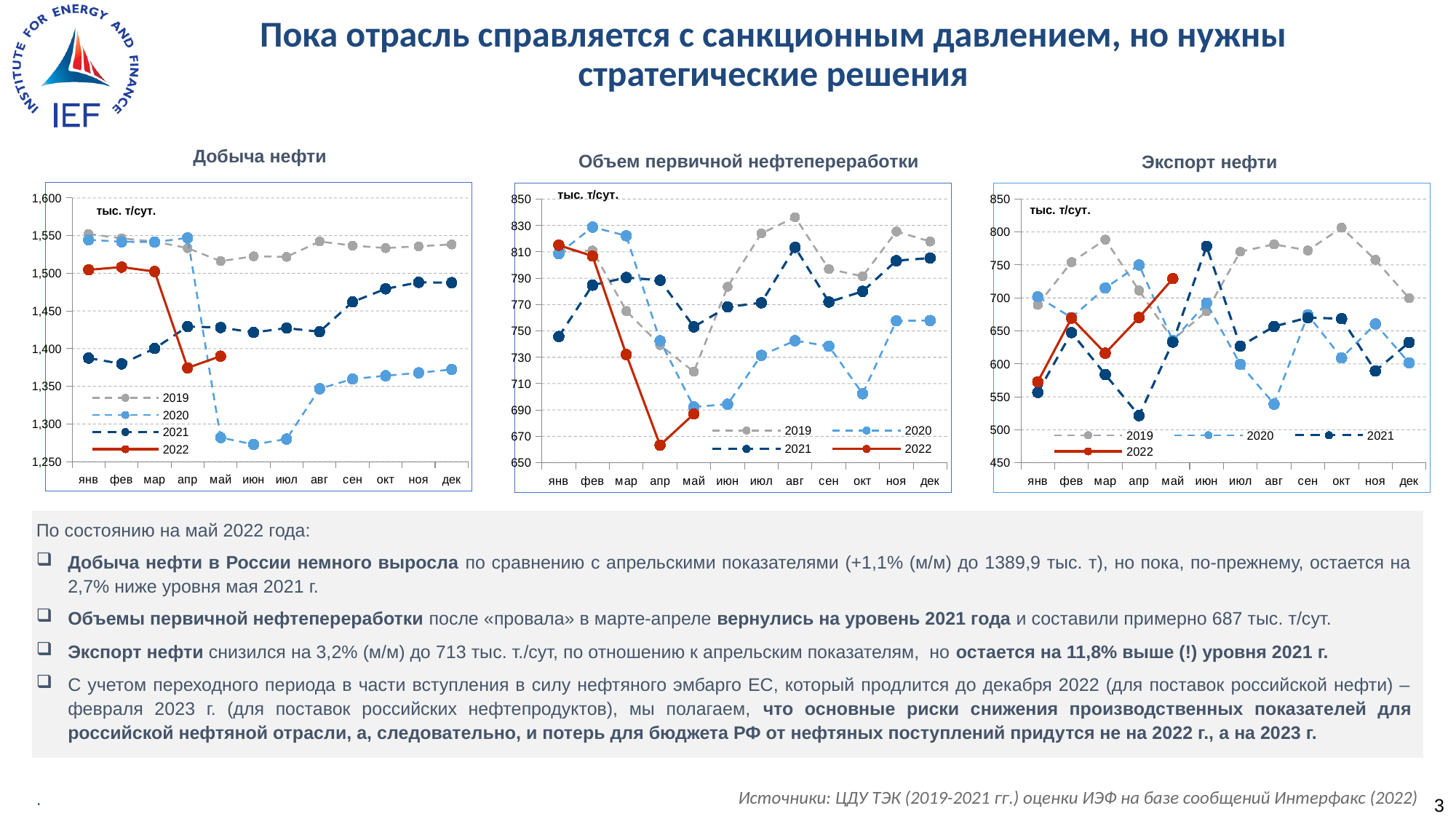
In the 'Объем первичной нефтепереработки' chart, in which month does the 2019 series reach its highest value? авг In the 'Добыча нефти' chart, is the 2022 value for апр greater or less than 1,400? less In the 'Объем первичной нефтепереработки' chart, is the 2022 value for апр greater or less than 670? less In the 'Добыча нефти' chart, does the 2022 line rise or fall from мар to апр? fall How many series does the legend of the 'Добыча нефти' chart list? 4 In the 'Добыча нефти' chart, is the 2020 value for июн greater or less than 1,300? less In the 'Экспорт нефти' chart, in which month does the 2021 series reach its lowest value? апр How many months are shown on the x axis of the 'Экспорт нефти' chart? 12 In the 'Добыча нефти' chart, which is higher in дек: 2019 or 2021? 2019 What kind of chart is the 'Добыча нефти' chart? line chart In the 'Объем первичной нефтепереработки' chart, in which month does the 2022 series reach its lowest value? апр What unit is shown on the 'Экспорт нефти' chart? тыс. т/сут.